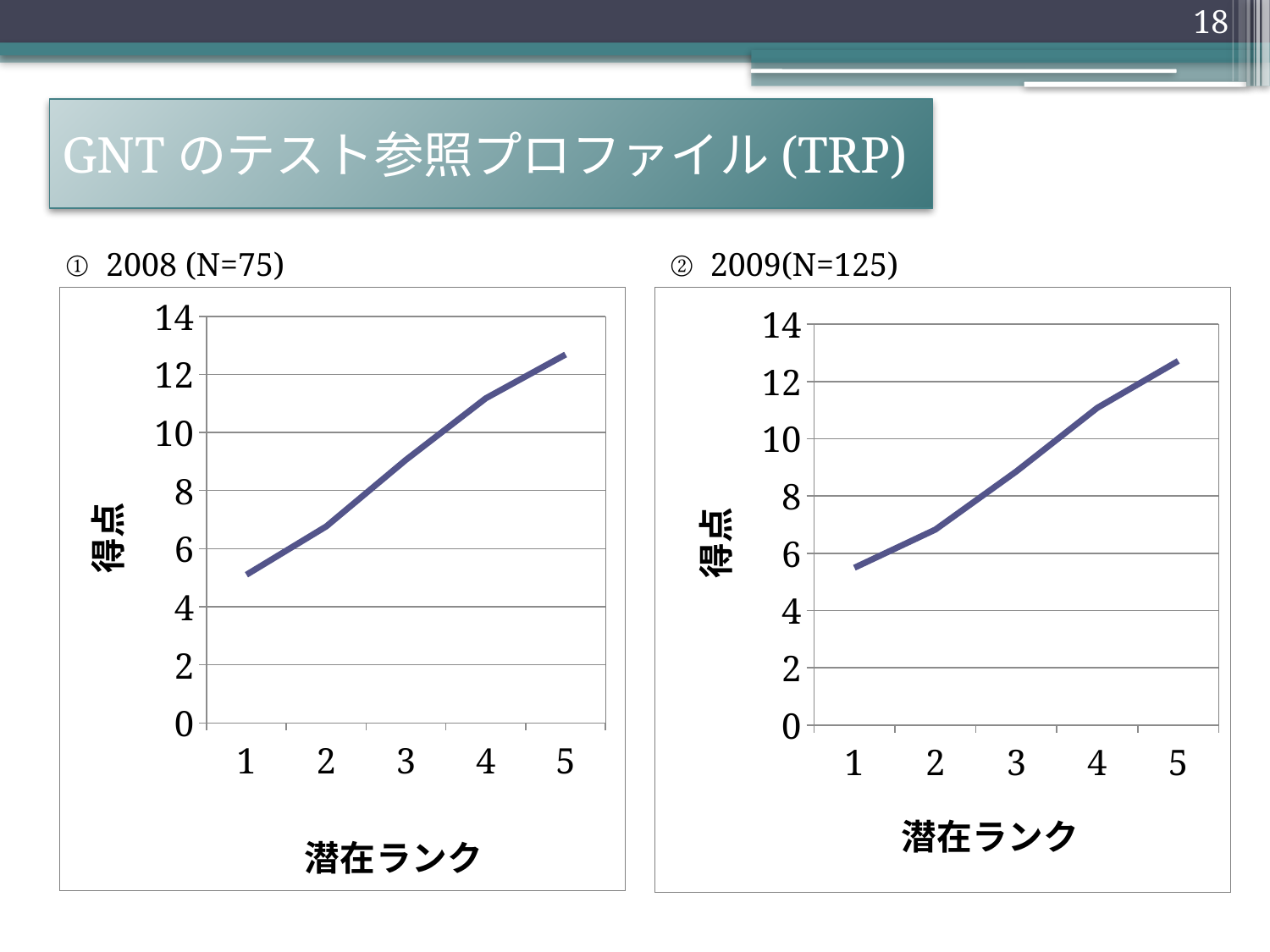
How many 潜在ランク categories are plotted on the x axis of the 2008 (N=75) chart? 5 What kind of chart is the 2008 (N=75) chart? line chart In the 2009 (N=125) chart, is the 得点 for 潜在ランク 4 greater or less than 10? greater In the 2009 (N=125) chart, do the scores rise or fall as 潜在ランク increases from 1 to 5? rise In the 2008 (N=75) chart, is the 得点 for 潜在ランク 5 greater or less than 12? greater In the 2008 (N=75) chart, which 潜在ランク has the highest 得点? 5 What is the y-axis label of the 2009 (N=125) chart? 得点 What is the x-axis label of the 2008 (N=75) chart? 潜在ランク In the 2008 (N=75) chart, is the 得点 for 潜在ランク 1 greater or less than 6? less In the 2009 (N=125) chart, which 潜在ランク has the lowest 得点? 1 In the 2008 (N=75) chart, which has the larger 得点: 潜在ランク 2 or 潜在ランク 4? 潜在ランク 4